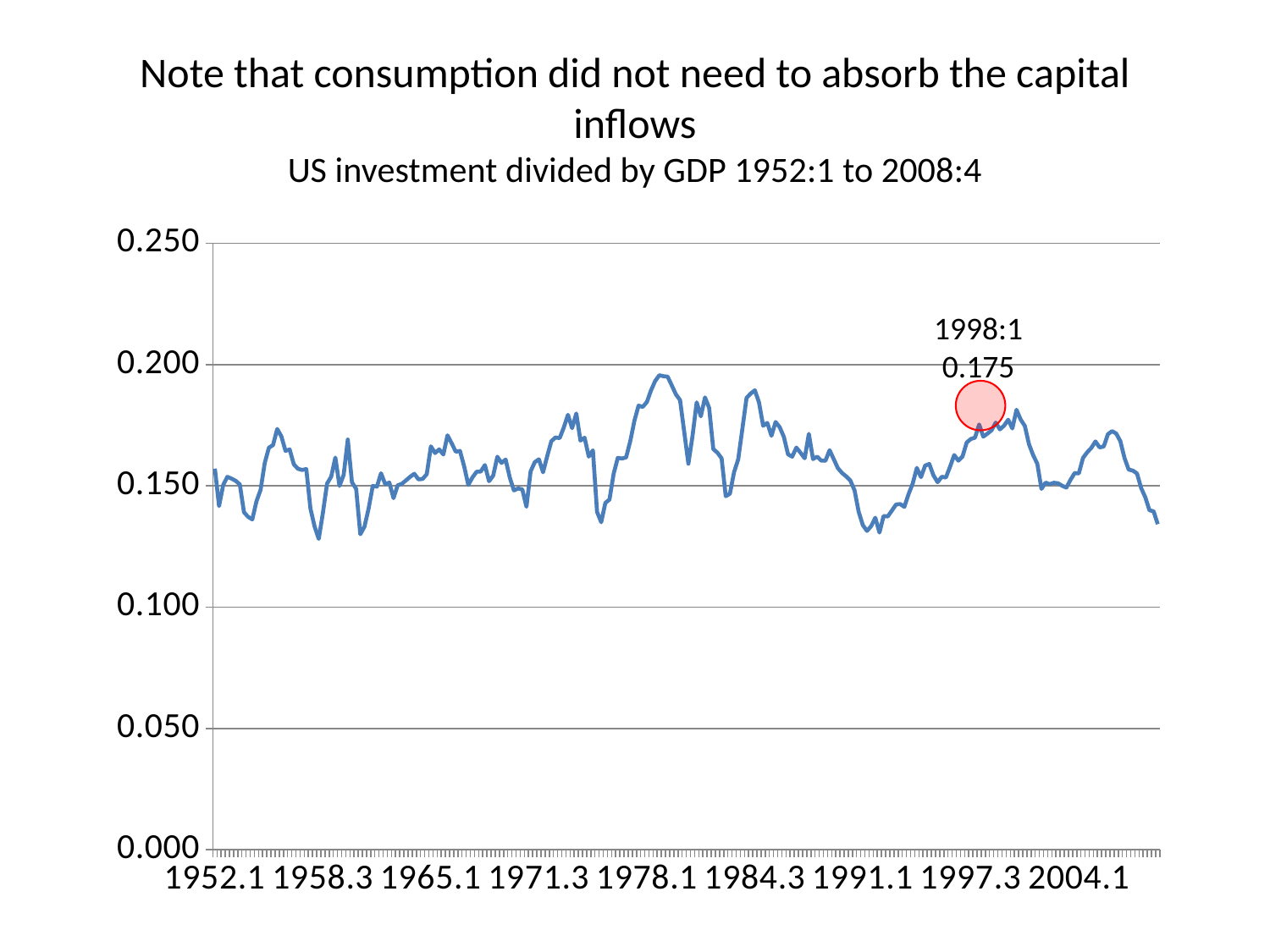
How many date labels are printed along the x axis? 9 Is the value at 1978.1 greater or less than 0.150? greater What is the subtitle describing the data series plotted on the chart? US investment divided by GDP 1952:1 to 2008:4 Between 1991.1 and 1997.3, do the values generally rise or fall? rise What kind of chart is shown on the slide? line chart Is the highest point on the line greater or less than 0.200? less What value is annotated on the chart for 1998:1? 0.175 What is the highest tick value shown on the y axis? 0.250 Is the value at 1991.1 greater or less than 0.150? less Which date is labelled with the annotation on the chart? 1998:1